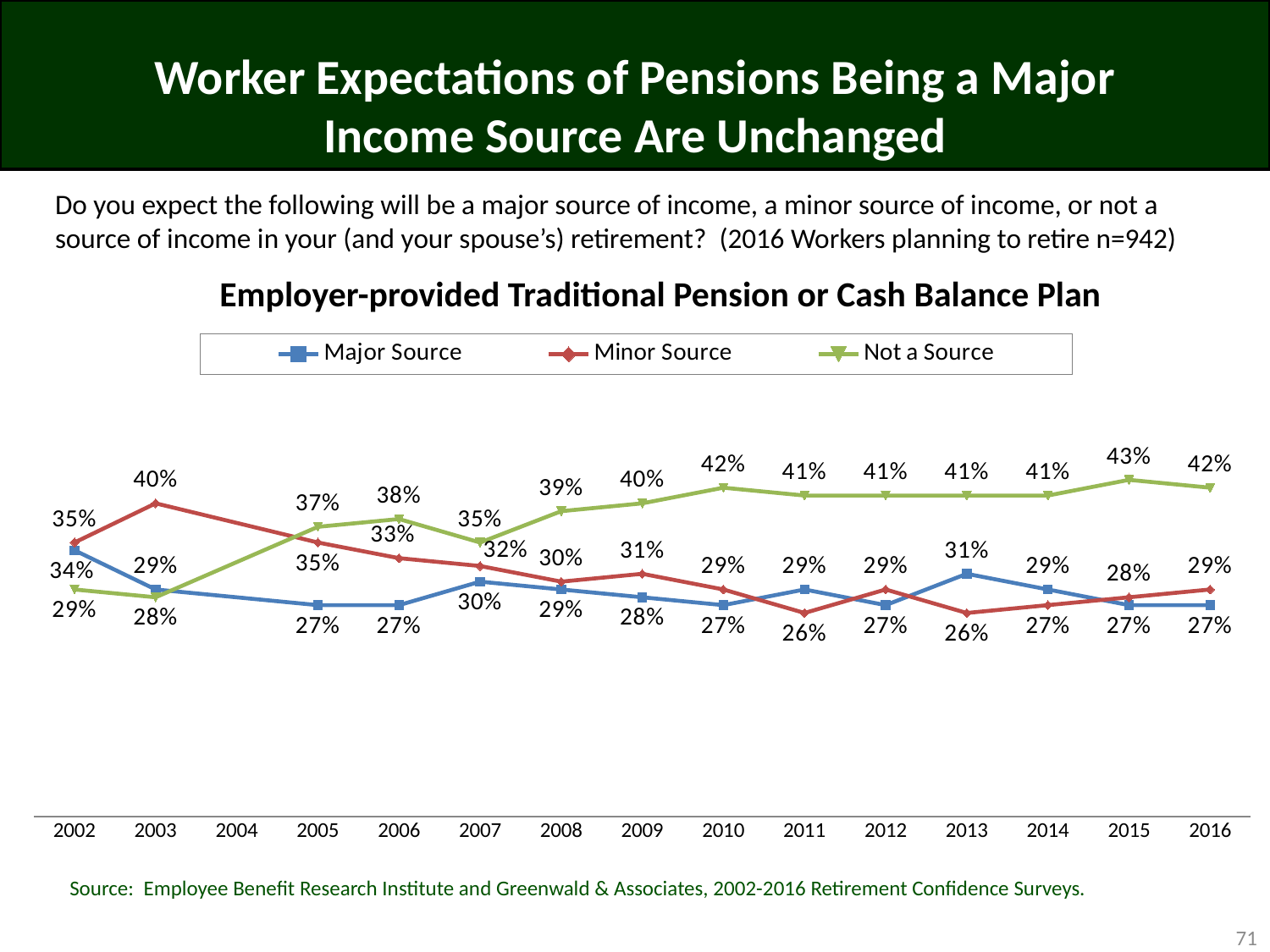
What is the lowest value shown for the Minor Source series? 26% In which year does the Not a Source series reach its highest value? 2015 What kind of chart is shown on the slide? Line chart Does the Not a Source series generally rise or fall from 2002 to 2016? Rise In which year is the Major Source value the highest? 2002 How many years are labelled on the x axis? 15 What is the value for Not a Source in 2015? 43% What percentage of workers said an employer-provided traditional pension would be a major source of income in 2016? 27% What is the value for Minor Source in 2003? 40% What is the difference between the Not a Source value and the Major Source value in 2016? 15 percentage points How many series does the legend list? 3 In 2002, which is larger: Major Source or Not a Source? Major Source